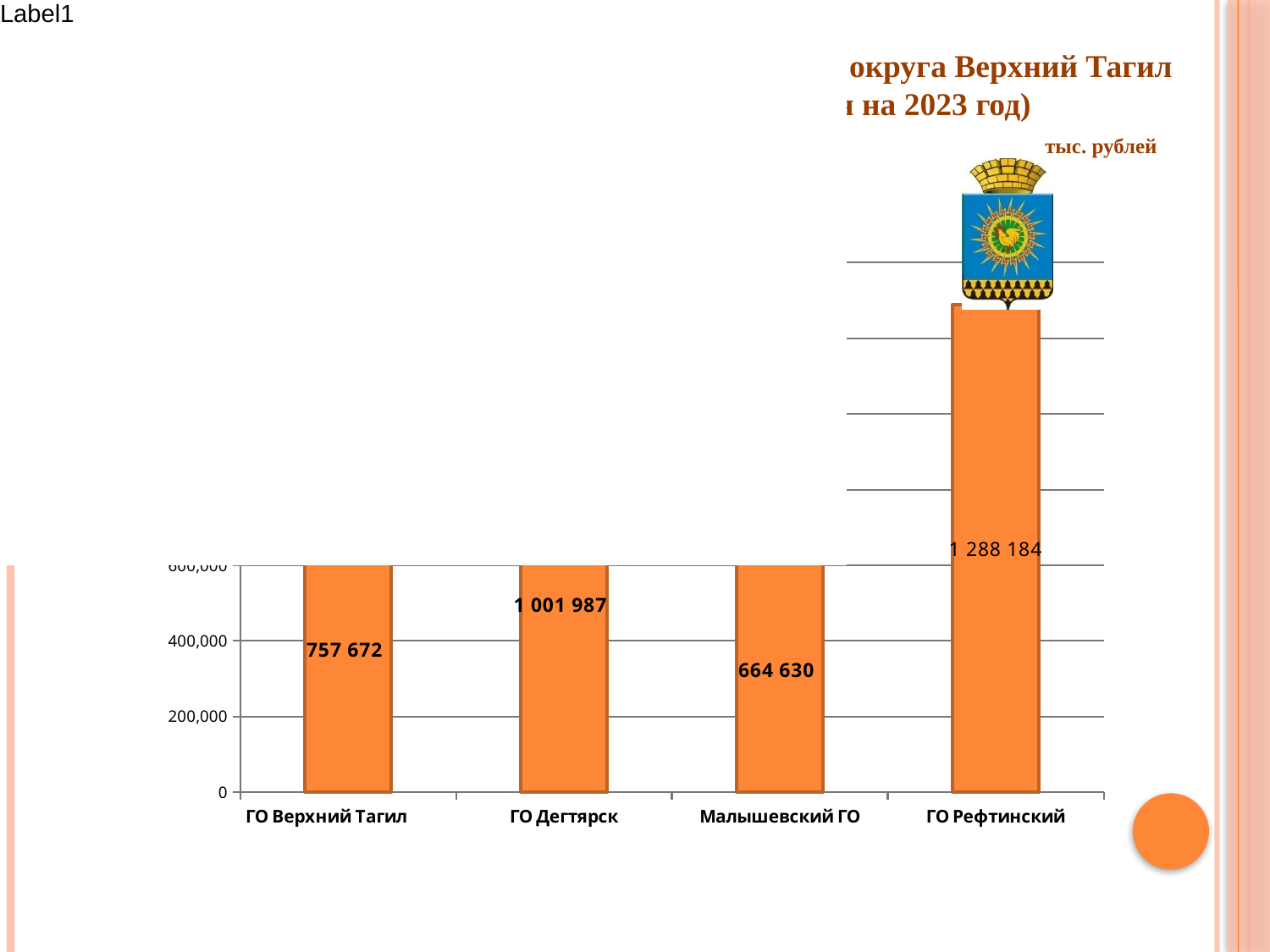
Which category has the highest value? ГО Рефтинский Which is larger, the value for ГО Дегтярск or the value for ГО Верхний Тагил? ГО Дегтярск How many categories are shown on the x axis? 4 What is the value for ГО Верхний Тагил? 757 672 What is the value for ГО Дегтярск? 1 001 987 What is the difference between the values for ГО Рефтинский and ГО Дегтярск? 286 197 What is the difference between the values for ГО Верхний Тагил and Малышевский ГО? 93 042 Which category has the lowest value? Малышевский ГО What is the value for ГО Рефтинский? 1 288 184 What is the value for Малышевский ГО? 664 630 What unit is stated for the values in the chart? тыс. рублей What kind of chart is shown on the slide? bar chart